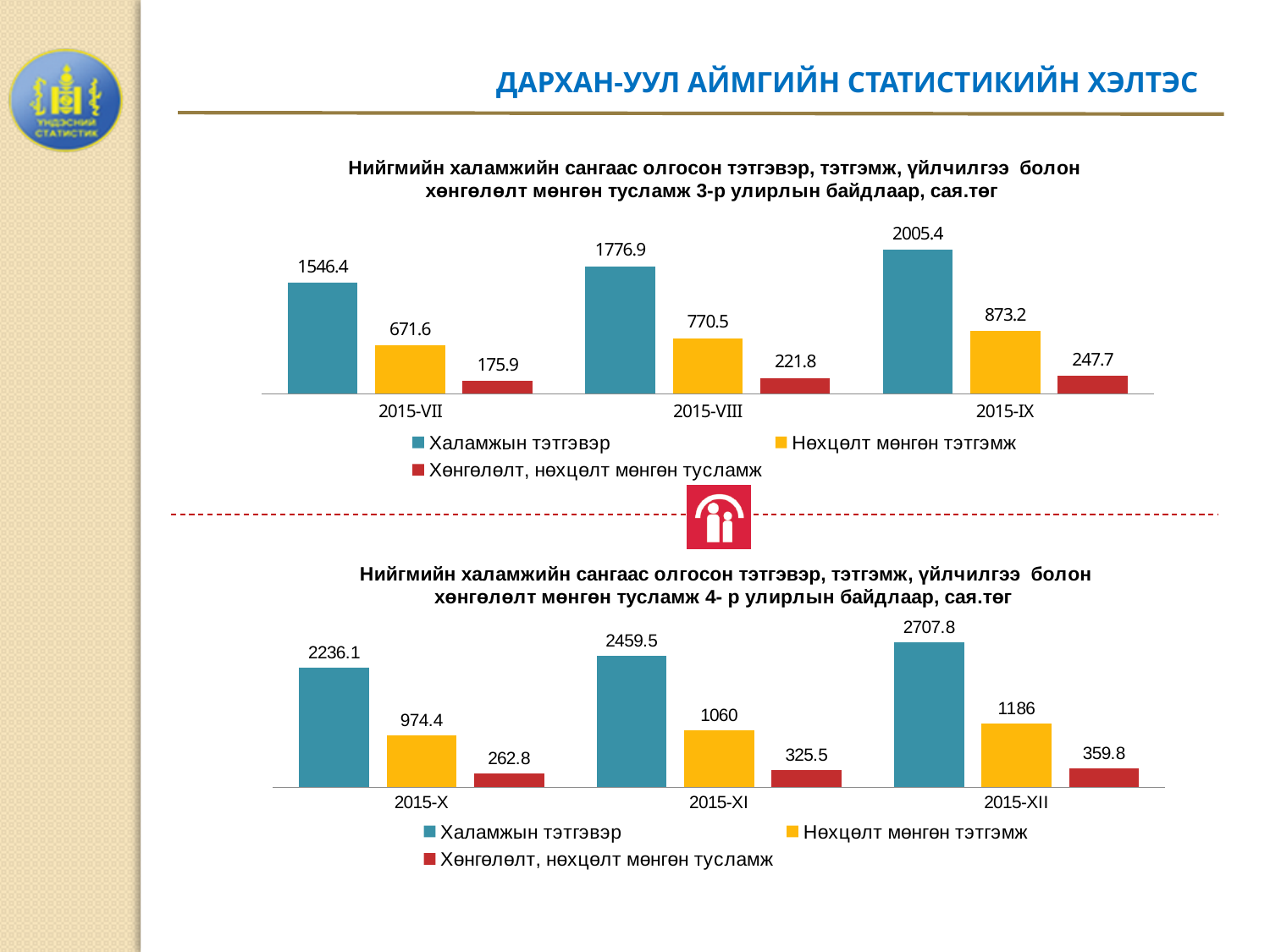
In the top chart (3-р улирал), does the value of Халамжын тэтгэвэр rise or fall from 2015-VII to 2015-IX? rise In the bottom chart (4-р улирал), how many months are shown on the x axis? 3 In the top chart (3-р улирал), which month has the highest value for Хөнгөлөлт, нөхцөлт мөнгөн тусламж? 2015-IX What type of chart is the bottom chart (4-р улирал)? bar chart In the bottom chart (4-р улирал), which is larger: Нөхцөлт мөнгөн тэтгэмж in 2015-X or in 2015-XI? 2015-XI In the top chart (3-р улирал), what is the value of Нөхцөлт мөнгөн тэтгэмж for 2015-IX? 873.2 In the bottom chart (4-р улирал), what is the value of Нөхцөлт мөнгөн тэтгэмж for 2015-XII? 1186 In the top chart (3-р улирал), what is the difference between Халамжын тэтгэвэр in 2015-IX and in 2015-VII? 459.0 In the bottom chart (4-р улирал), which month has the lowest value for Халамжын тэтгэвэр? 2015-X In the top chart (3-р улирал), what is the value of Халамжын тэтгэвэр for 2015-VIII? 1776.9 In the bottom chart (4-р улирал), what is the value of Хөнгөлөлт, нөхцөлт мөнгөн тусламж for 2015-XI? 325.5 In the top chart (3-р улирал), how many series does the legend list? 3